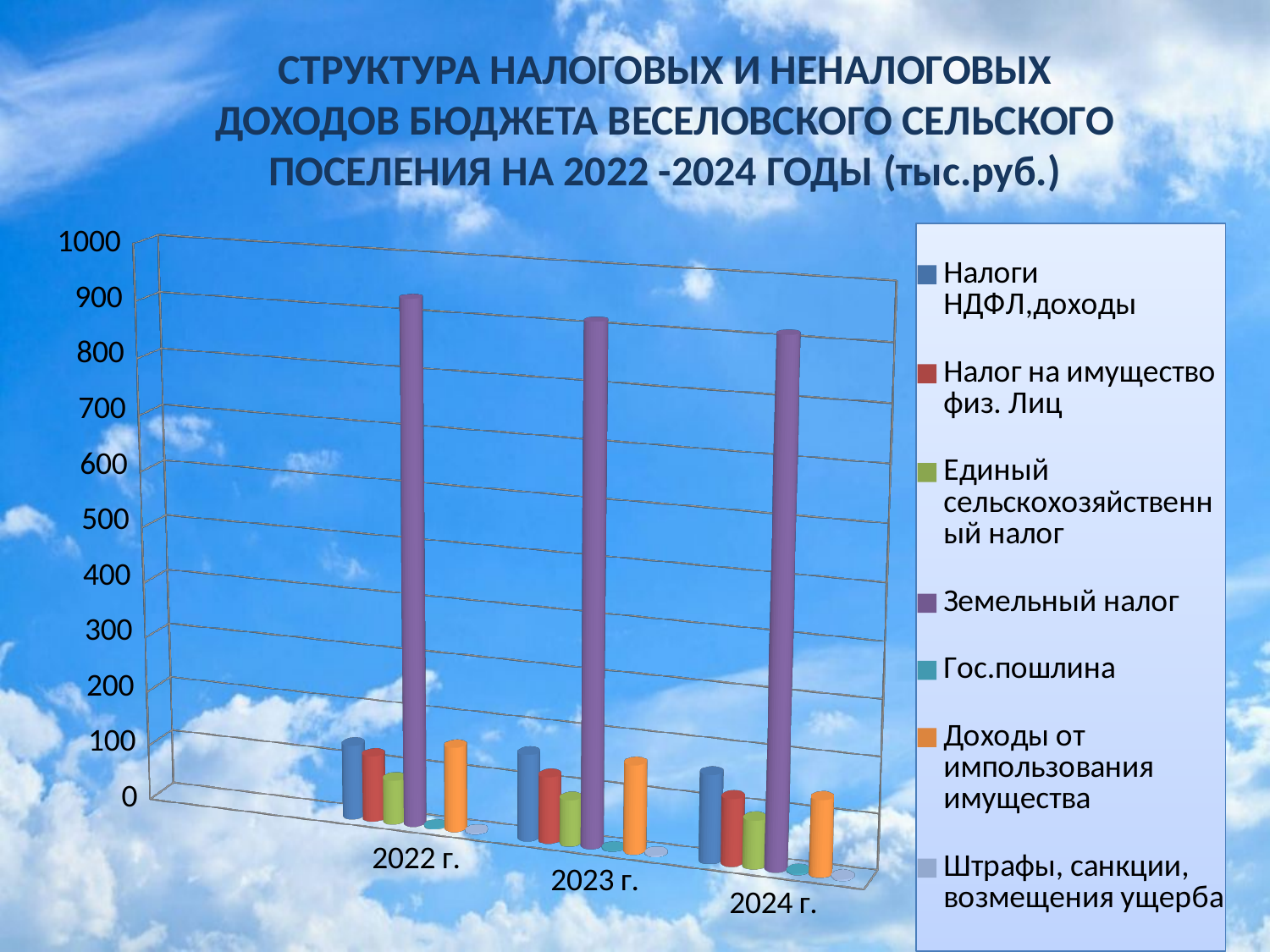
Which is larger: Земельный налог in 2022 or Земельный налог in 2024? Земельный налог in 2022 Which series has the highest value in 2024? Земельный налог What kind of chart is shown on the slide? bar chart Does the value of Земельный налог rise or fall from 2022 to 2024? fall Which series has the highest value in 2022? Земельный налог Is the value of Земельный налог in 2024 greater or less than 500? greater Which colour represents Земельный налог in the legend? purple How many year categories are shown on the x axis of the chart? 3 What unit of measurement is stated in the chart title? тыс.руб. How many series does the chart legend list? 7 Is the value of Земельный налог in 2022 greater or less than 800? greater